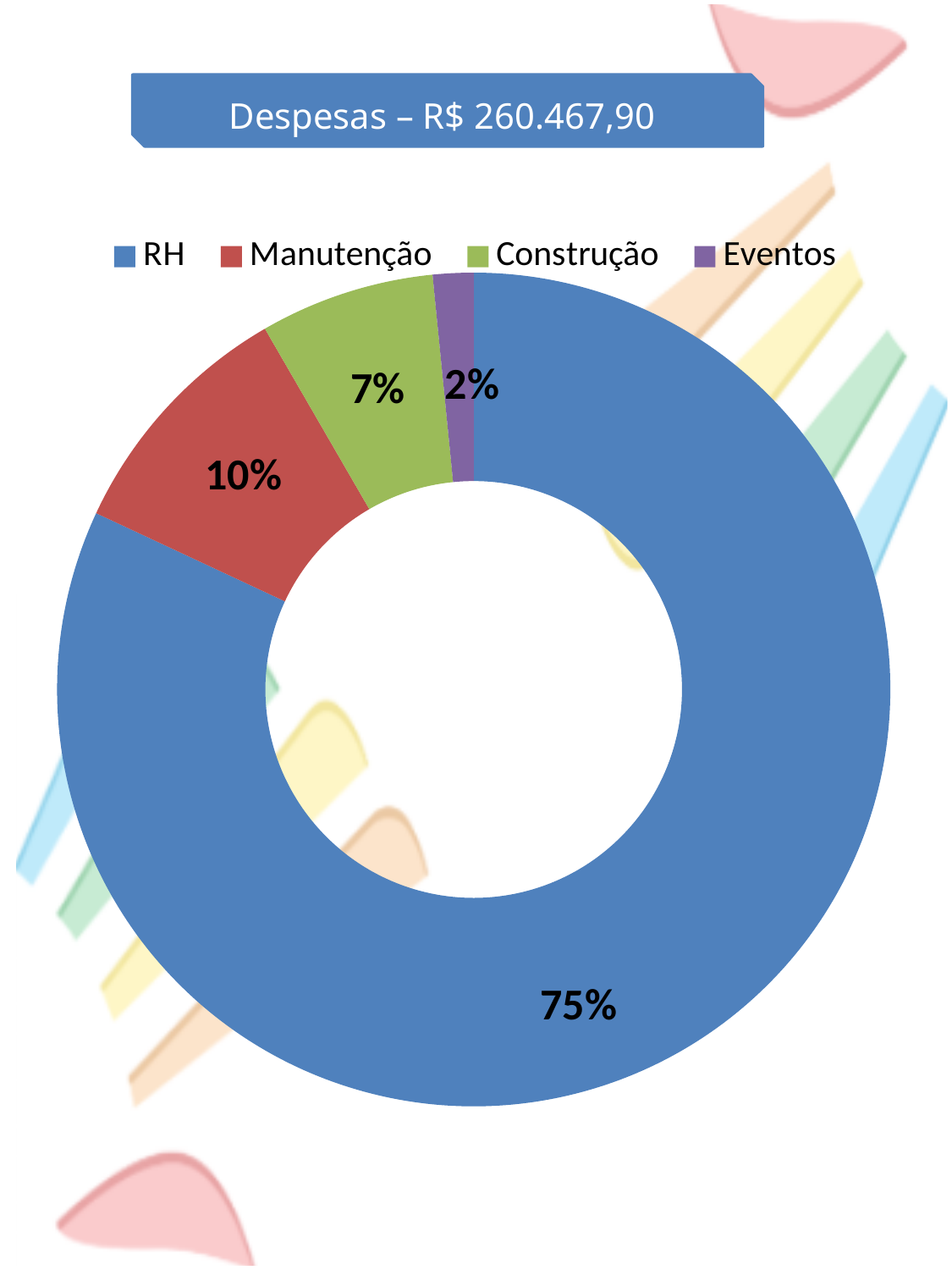
How many categories are shown in the chart? 4 Which category has the largest share of expenses? RH What share of expenses does Eventos account for? 2% What share of expenses does Construção account for? 7% What colour represents Manutenção in the chart? Red What kind of chart is shown on the slide? Pie chart (doughnut) What share of expenses does RH account for? 75% Which has a larger share, Construção or Eventos? Construção Which category has the smallest share of expenses? Eventos What share of expenses does Manutenção account for? 10% What is the title shown above the chart? Despesas – R$ 260.467,90 What is the difference in percentage points between the RH share and the Manutenção share? 65